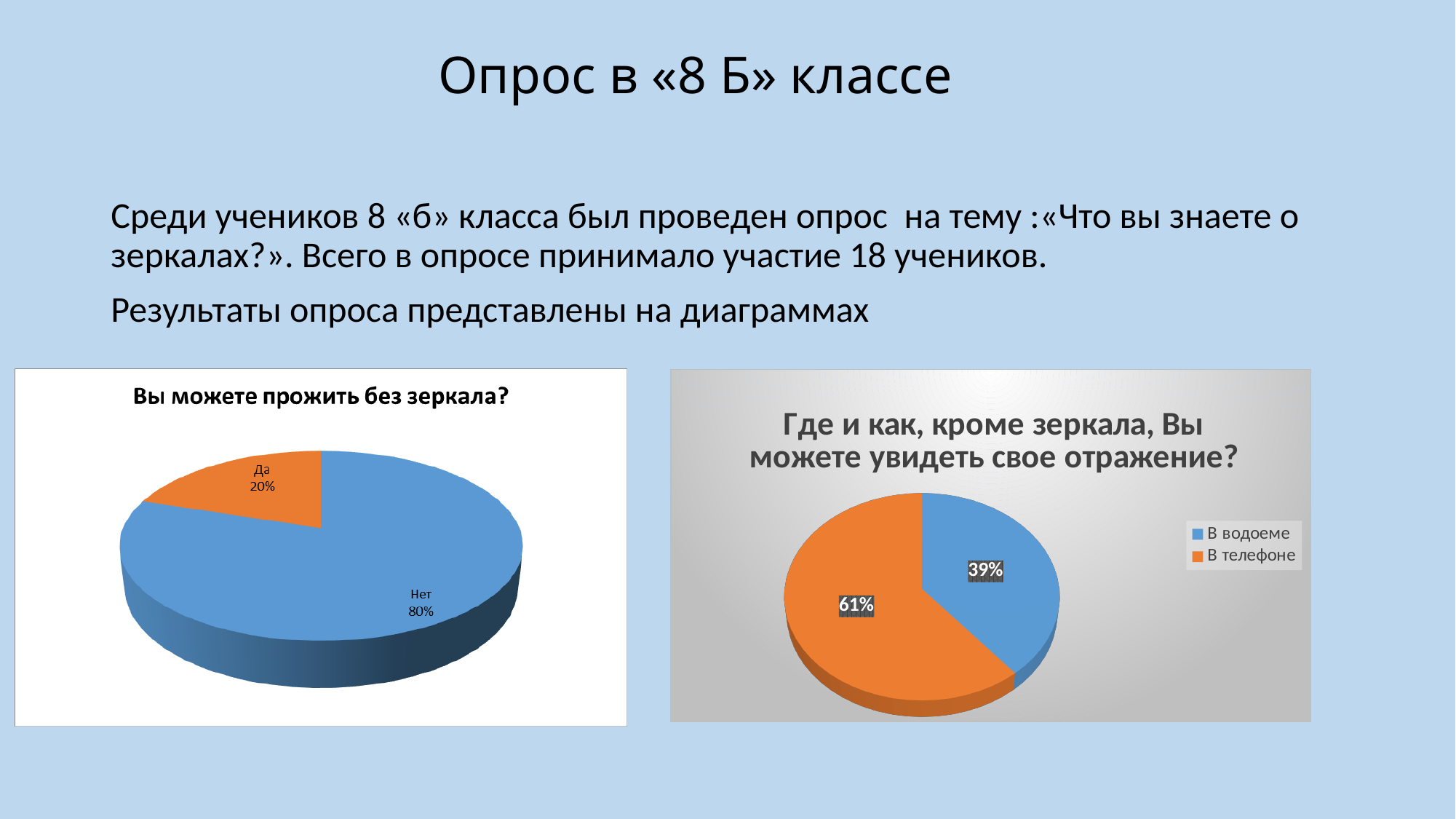
In the right chart titled "Где и как, кроме зеркала, Вы можете увидеть свое отражение?", which is larger: "В водоеме" or "В телефоне"? В телефоне In the left chart titled "Вы можете прожить без зеркала?", which answer has the largest slice? Нет In the left chart titled "Вы можете прожить без зеркала?", what share of respondents answered "Нет"? 80% How many entries does the legend of the right chart titled "Где и как, кроме зеркала, Вы можете увидеть свое отражение?" list? 2 In the right chart titled "Где и как, кроме зеркала, Вы можете увидеть свое отражение?", which category has the smallest slice? В водоеме In the left chart titled "Вы можете прожить без зеркала?", what share of respondents answered "Да"? 20% In the right chart titled "Где и как, кроме зеркала, Вы можете увидеть свое отражение?", what share is labelled for "В водоеме"? 39% In the right chart titled "Где и как, кроме зеркала, Вы можете увидеть свое отражение?", what colour is the "В телефоне" slice? Orange What kind of chart is the left chart titled "Вы можете прожить без зеркала?"? Pie chart In the left chart titled "Вы можете прожить без зеркала?", what is the difference in percentage points between "Нет" and "Да"? 60 percentage points How many slices does the left chart titled "Вы можете прожить без зеркала?" have? 2 In the right chart titled "Где и как, кроме зеркала, Вы можете увидеть свое отражение?", what share is labelled for "В телефоне"? 61%